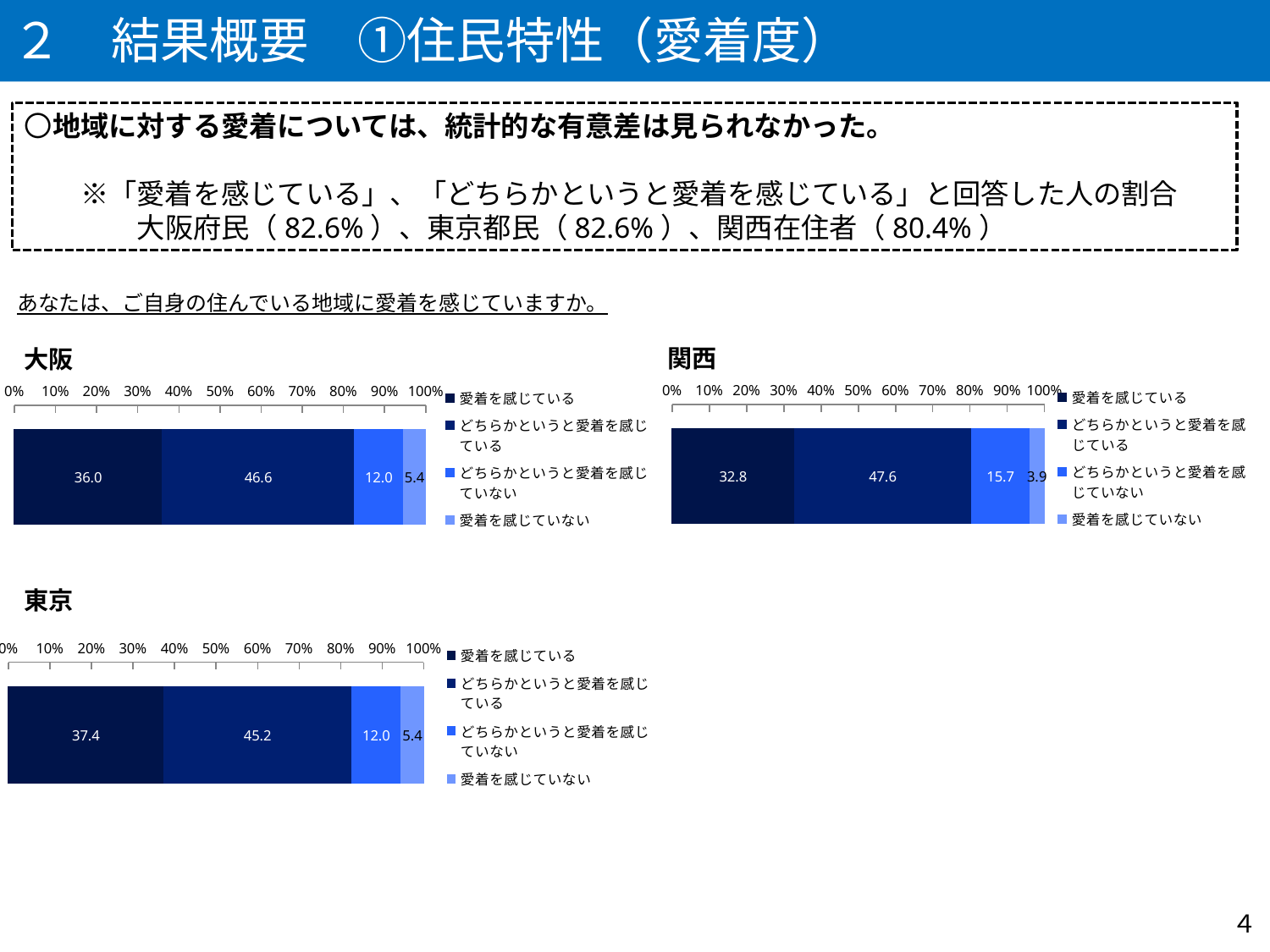
How many series does the legend of the 関西 chart list? 4 In the 東京 chart, what is the difference between 愛着を感じている and どちらかというと愛着を感じている? 7.8 In the 大阪 chart, what is the value for 愛着を感じている? 36.0 How many charts are shown on the slide? 3 In the 大阪 chart, what is the total of 愛着を感じている and どちらかというと愛着を感じている? 82.6 In the 関西 chart, which segment has the smallest value? 愛着を感じていない Which is larger: 愛着を感じている in the 大阪 chart or 愛着を感じている in the 東京 chart? 東京 In the 東京 chart, what is the value for 愛着を感じていない? 5.4 In the 関西 chart, what is the value for どちらかというと愛着を感じている? 47.6 In the 関西 chart, what is the value for どちらかというと愛着を感じていない? 15.7 In the 大阪 chart, which segment has the largest value? どちらかというと愛着を感じている What kind of chart is the 東京 chart? Stacked bar chart